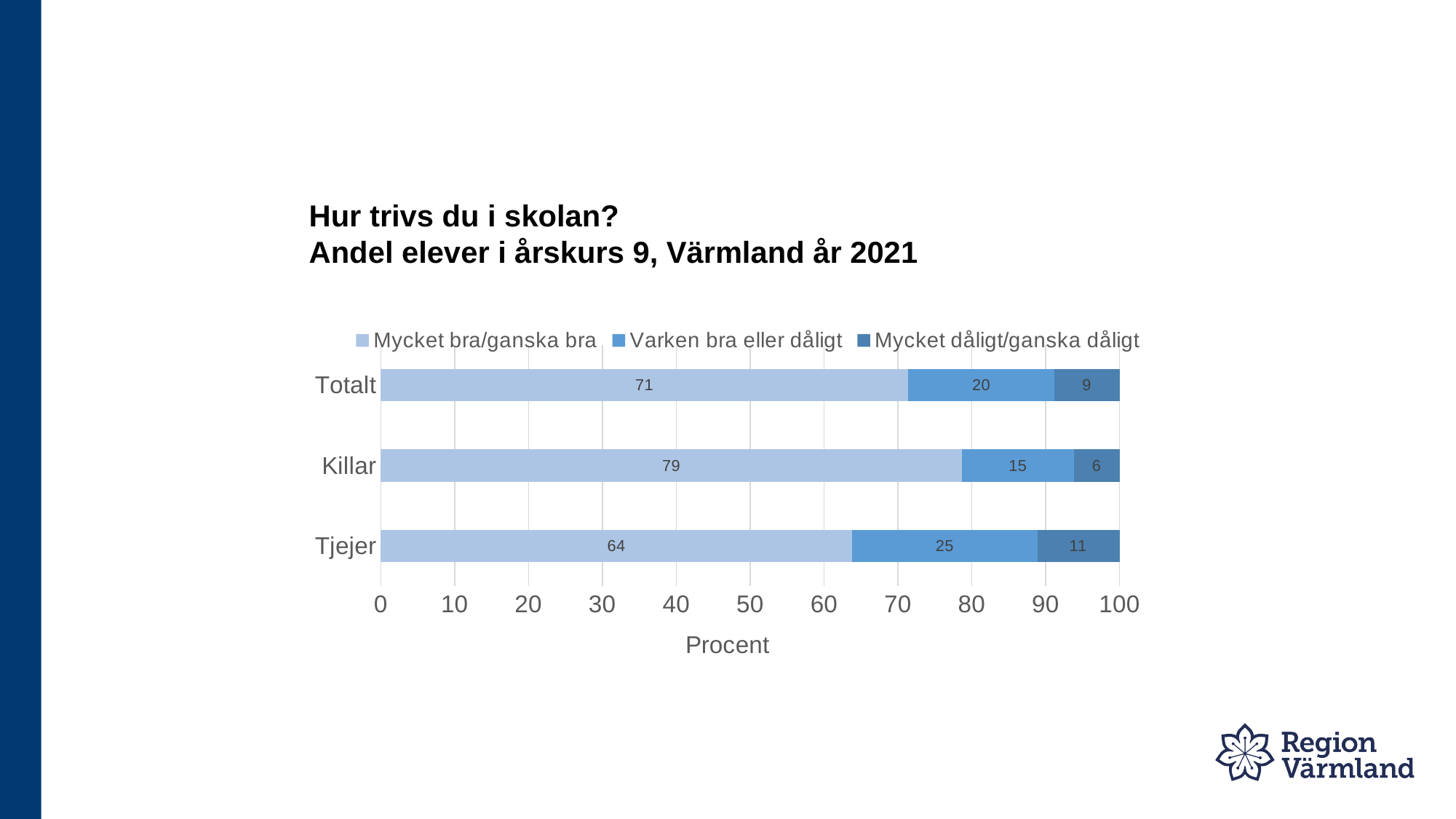
Which category has the lowest value for 'Mycket dåligt/ganska dåligt'? Killar What is the value for 'Varken bra eller dåligt' for Tjejer? 25 What is the value for 'Mycket dåligt/ganska dåligt' for Killar? 6 What is the difference between the 'Mycket bra/ganska bra' values for Killar and Tjejer? 15 Which is larger: the 'Varken bra eller dåligt' value for Tjejer or for Totalt? Tjejer What kind of chart is shown on the slide? Stacked bar chart Which category has the highest value for 'Mycket bra/ganska bra'? Killar How many series does the legend list? 3 What is the total of the stacked bar for Tjejer? 100 How many categories are shown on the y axis? 3 What is the value for 'Mycket bra/ganska bra' for Totalt? 71 What is the label of the x axis? Procent